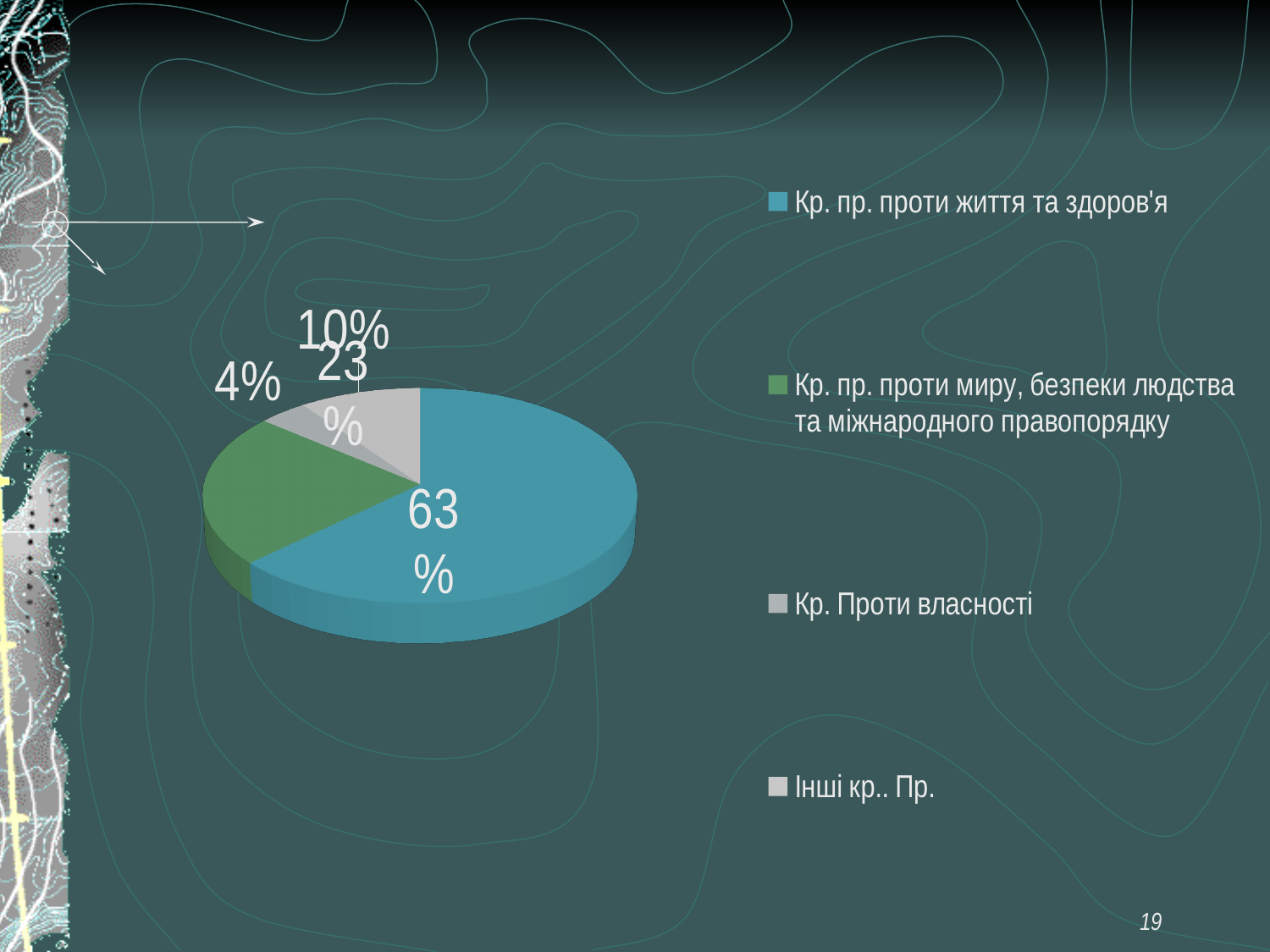
What kind of chart is shown on the slide? pie chart What percentage is shown for 'Кр. Проти власності'? 4% How many slices does the pie chart have? 4 What colour is the slice for 'Кр. пр. проти життя та здоров'я'? blue What percentage is shown for 'Кр. пр. проти миру, безпеки людства та міжнародного правопорядку'? 23% What percentage of the pie is labelled for 'Кр. пр. проти життя та здоров'я'? 63% Which category has the smallest share of the pie? Кр. Проти власності What percentage is shown for 'Інші кр.. Пр.'? 10% Which is larger: the share for 'Інші кр.. Пр.' or the share for 'Кр. Проти власності'? Інші кр.. Пр. How many entries does the legend list? 4 Which category has the largest share of the pie? Кр. пр. проти життя та здоров'я What is the difference in percentage points between the 63% slice and the 23% slice? 40